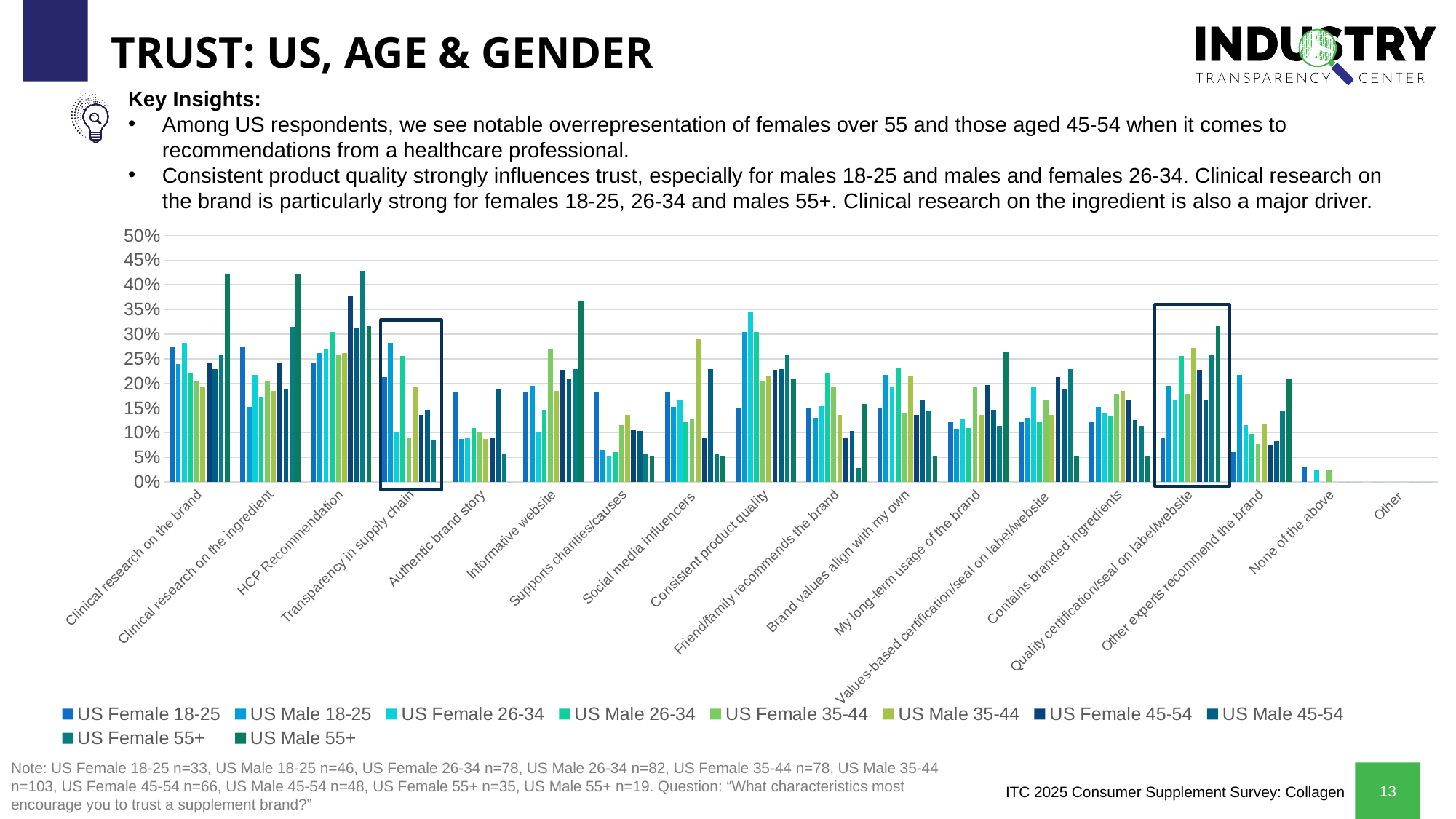
How many categories are shown along the x axis of the chart? 18 Is the value for US Male 55+ in the 'Clinical research on the brand' category greater or less than 40%? greater How many series does the chart legend list? 10 Is the value for US Female 26-34 in the 'Consistent product quality' category greater or less than 30%? greater Which series has the highest value in the 'HCP Recommendation' category? US Female 55+ Is the value for US Female 18-25 in the 'None of the above' category greater or less than 5%? less What kind of chart is shown on the slide? Bar chart How many categories on the chart are outlined with a dark rectangle? 2 Which category has the lowest values across all series? Other Which series has the highest value in the 'Consistent product quality' category? US Female 26-34 In the 'Clinical research on the brand' category, which is larger: the value for US Male 55+ or the value for US Female 18-25? US Male 55+